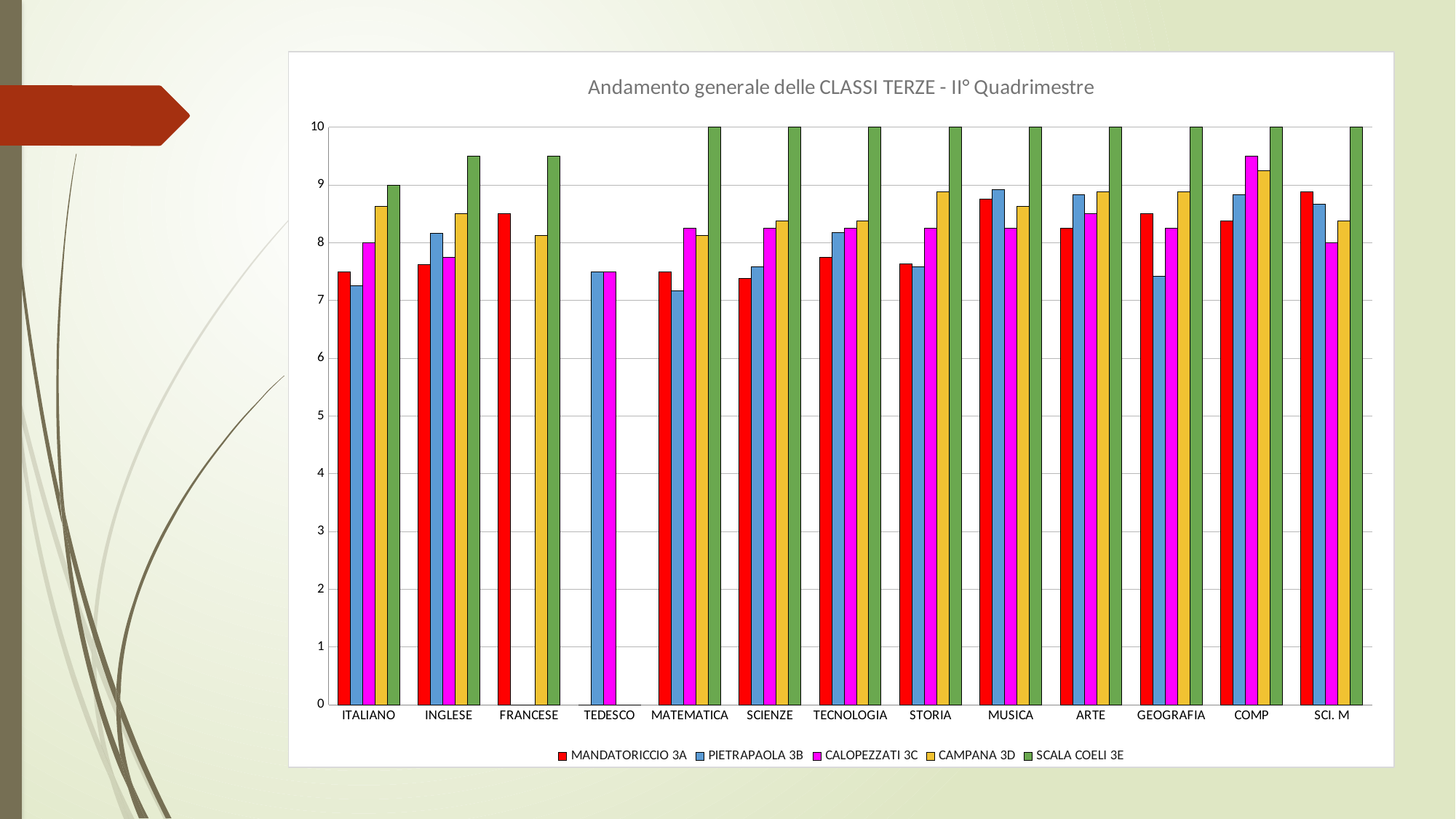
How many series does the legend list? 5 In GEOGRAFIA, which series has the lowest value? PIETRAPAOLA 3B Is the value for CALOPEZZATI 3C in COMP greater or less than 9? greater In MUSICA, which is larger: PIETRAPAOLA 3B or CALOPEZZATI 3C? PIETRAPAOLA 3B What is the title of the chart? Andamento generale delle CLASSI TERZE - II° Quadrimestre In ITALIANO, which is larger: CAMPANA 3D or MANDATORICCIO 3A? CAMPANA 3D What is the value for SCALA COELI 3E in ITALIANO? 9 What is the value for SCALA COELI 3E in MATEMATICA? 10 Is the value for MANDATORICCIO 3A in FRANCESE greater or less than 8? greater Is the value for PIETRAPAOLA 3B in ITALIANO greater or less than 8? less What kind of chart is shown on the slide? bar chart How many subject categories are shown on the x axis? 13